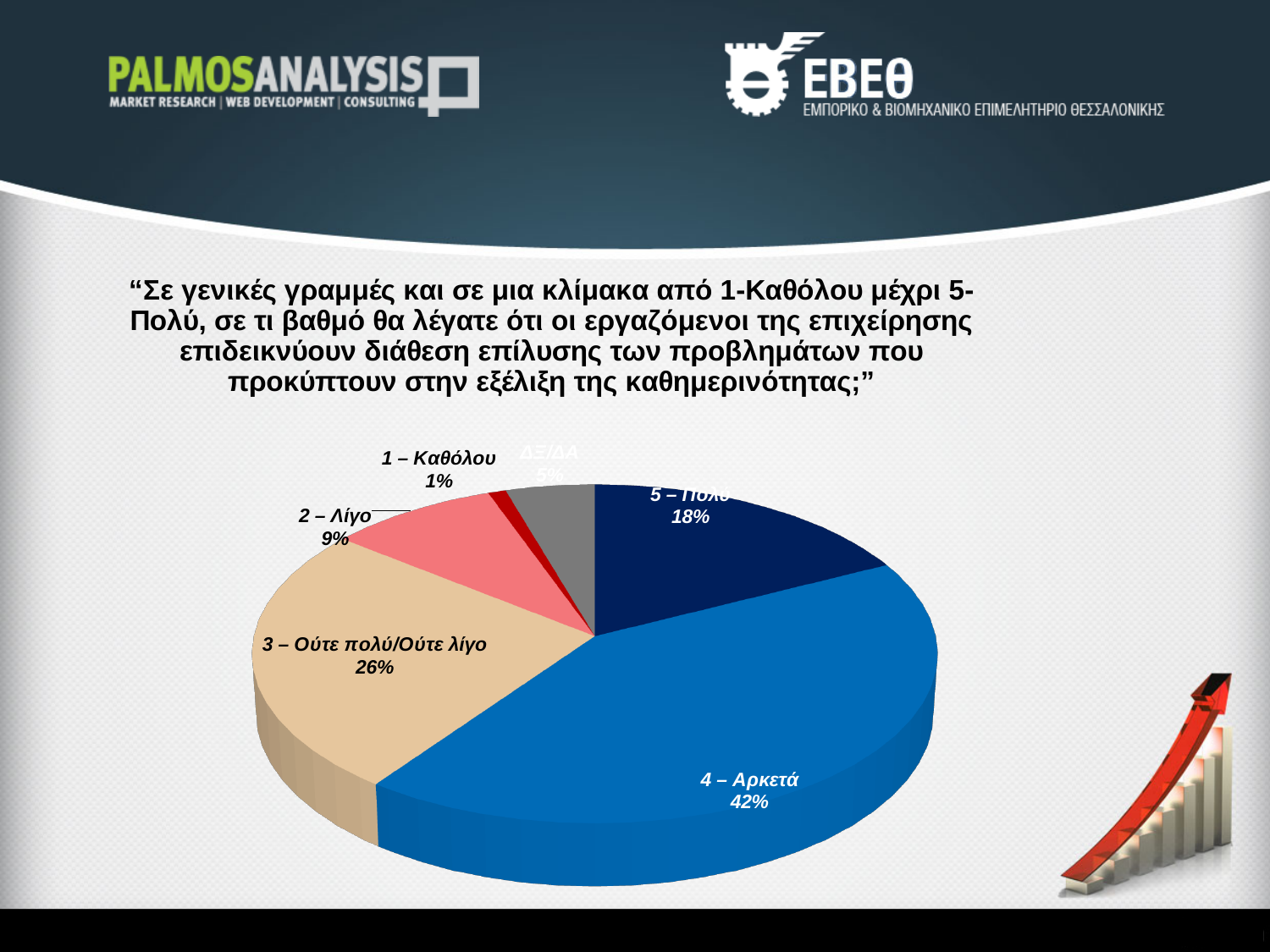
Which is larger, the share for "5 – Πολύ" or the share for "2 – Λίγο"? 5 – Πολύ What percentage is shown for the slice "2 – Λίγο"? 9% What percentage is shown for the slice "4 – Αρκετά"? 42% What percentage is shown for the slice "1 – Καθόλου"? 1% What percentage is shown for the slice "3 – Ούτε πολύ/Ούτε λίγο"? 26% How many slices does the pie chart have? 6 What colour is the slice for "4 – Αρκετά"? blue Which slice of the pie chart has the largest share? 4 – Αρκετά Which slice of the pie chart has the smallest share? 1 – Καθόλου What percentage is shown for the slice "5 – Πολύ"? 18% What kind of chart is shown on the slide? pie chart What is the difference in percentage points between "4 – Αρκετά" and "3 – Ούτε πολύ/Ούτε λίγο"? 16